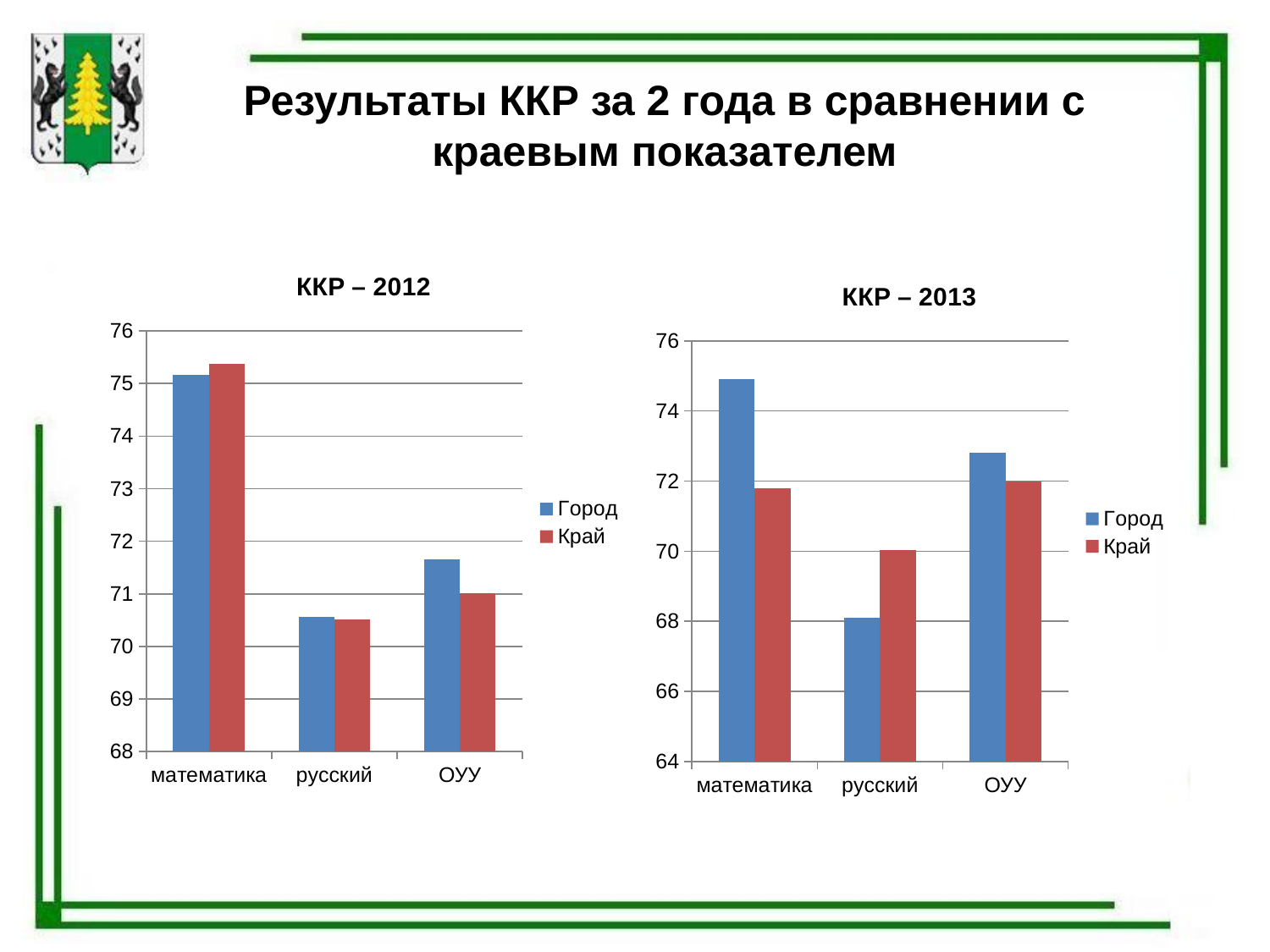
In the ККР – 2013 chart, which is larger for русский: Город or Край? Край In the ККР – 2012 chart, which category has the lowest value for Край? русский What are the two legend entries of the ККР – 2012 chart? Город, Край In the ККР – 2013 chart, which category has the lowest value for Город? русский In the ККР – 2012 chart, which category has the highest value for Город? математика In the ККР – 2012 chart, is the value for Край in математика greater or less than 75? greater What kind of chart is the ККР – 2012 chart? bar chart How many series does the legend of the ККР – 2013 chart list? 2 In the ККР – 2012 chart, is the value for Город in ОУУ greater or less than 71? greater How many categories are shown on the x axis of the ККР – 2012 chart? 3 In the ККР – 2013 chart, which is larger for математика: Город or Край? Город In the ККР – 2013 chart, is the value for Город in математика greater or less than 74? greater